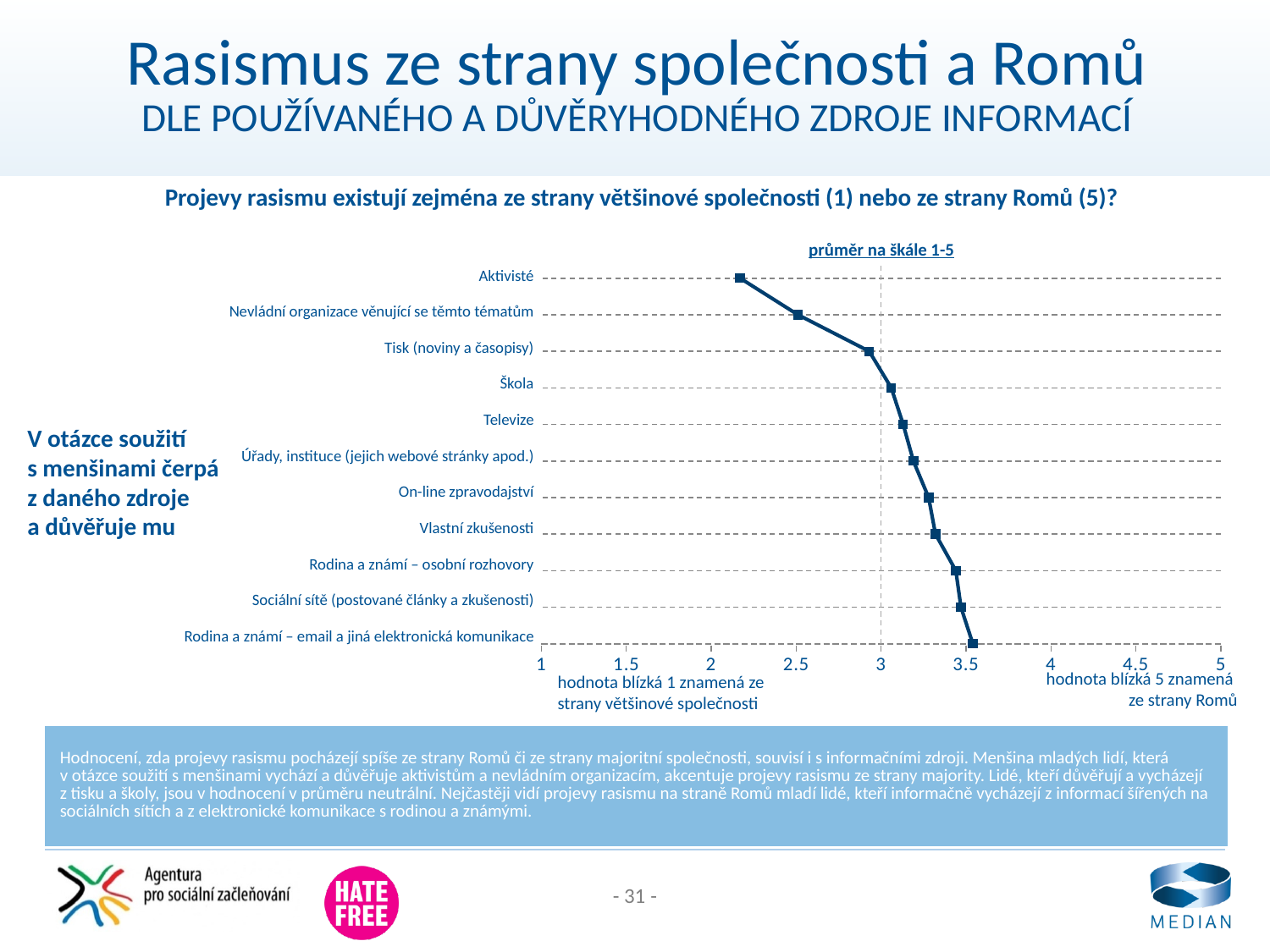
Which has the larger value: Nevládní organizace věnující se těmto tématům or Sociální sítě (postované články a zkušenosti)? Sociální sítě (postované články a zkušenosti) How many information sources (categories) are plotted on the chart? 11 Do the values rise or fall when moving down the list of categories from Aktivisté to Rodina a známí – email a jiná elektronická komunikace? rise What kind of chart is shown on the slide? line chart Is the value for Úřady, instituce (jejich webové stránky apod.) greater or less than 3? greater Which category has the lowest value on the chart? Aktivisté Which category has the highest value on the chart? Rodina a známí – email a jiná elektronická komunikace Is the value for Aktivisté greater or less than 2.5? less Is the value for On-line zpravodajství greater or less than 3.5? less What is the title shown above the chart? průměr na škále 1-5 Which has the larger value: Aktivisté or Tisk (noviny a časopisy)? Tisk (noviny a časopisy)